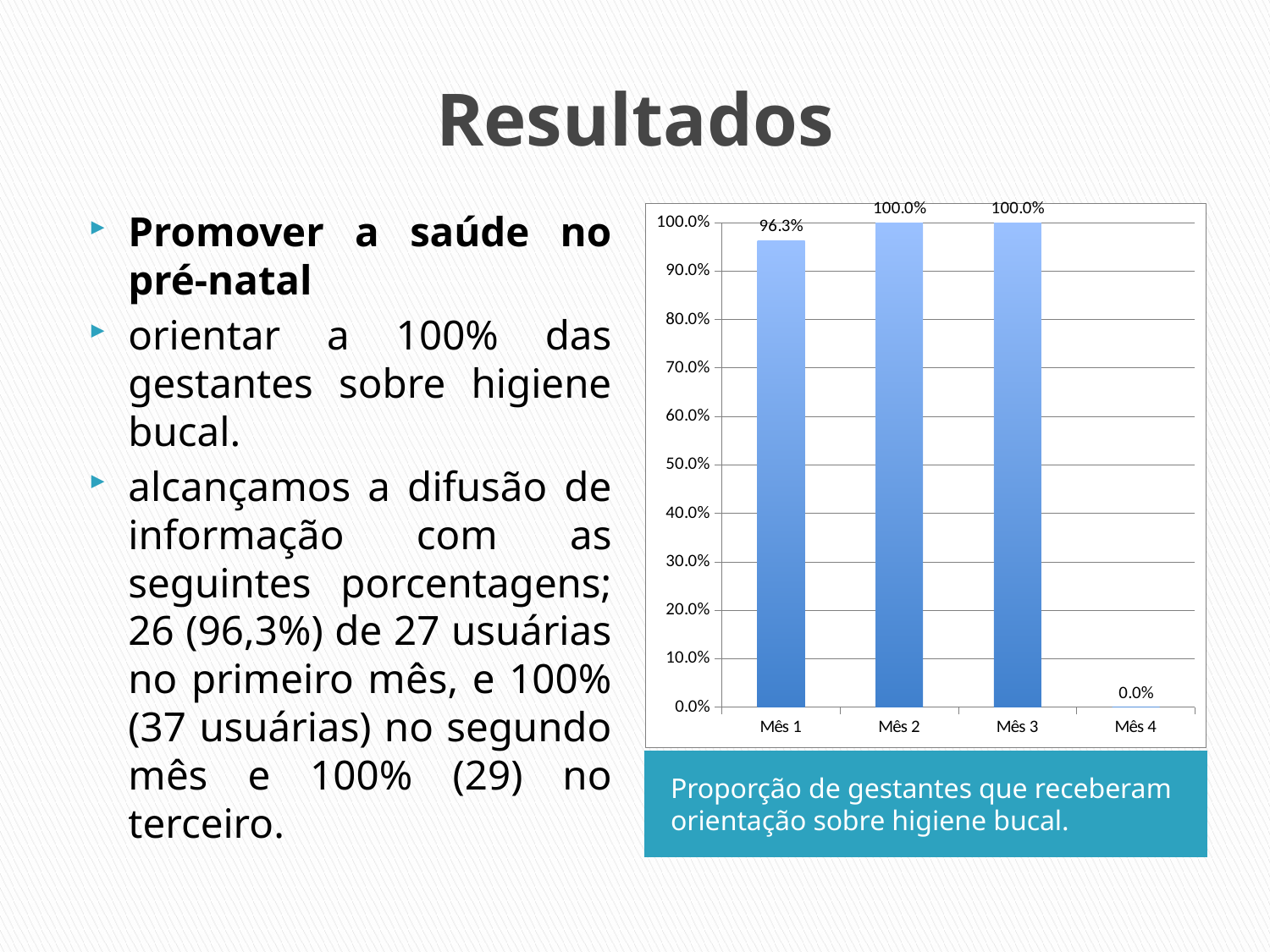
Is the value for Mês 1 greater or less than 90.0%? greater What kind of chart is shown on the slide? bar chart What is the value for Mês 4? 0.0% Do the values rise or fall from Mês 1 to Mês 2? rise How many categories are shown on the x axis? 4 Which is larger, the value for Mês 1 or the value for Mês 3? Mês 3 What is the value for Mês 2? 100.0% Which month has the lowest value? Mês 4 What is the difference between the values for Mês 2 and Mês 1? 3.7% What is the value for Mês 1? 96.3% What does the caption below the chart say the chart shows? Proporção de gestantes que receberam orientação sobre higiene bucal. What is the highest value shown on the y axis? 100.0%